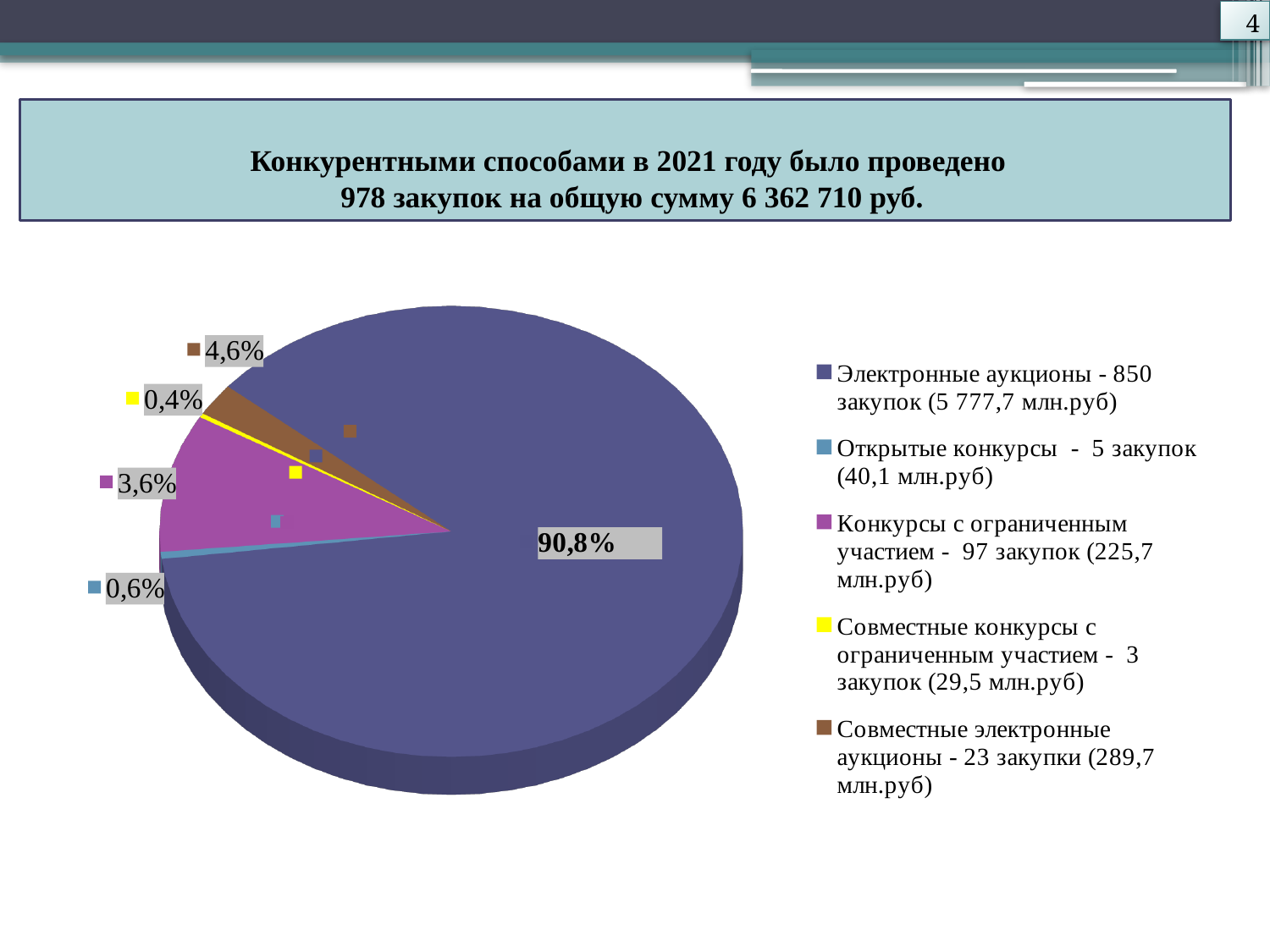
Which category has the smallest slice of the pie? Совместные конкурсы с ограниченным участием How many purchases does the legend list for "Электронные аукционы"? 850 What share of the pie does "Конкурсы с ограниченным участием" take? 3,6% Which category has the largest slice of the pie? Электронные аукционы How many slices does the pie chart have? 5 What is the difference in percentage points between the "Совместные электронные аукционы" slice and the "Конкурсы с ограниченным участием" slice? 1,0% What share of the pie does "Совместные конкурсы с ограниченным участием" take? 0,4% What share of the pie does "Совместные электронные аукционы" take? 4,6% What kind of chart is shown on the slide? pie chart